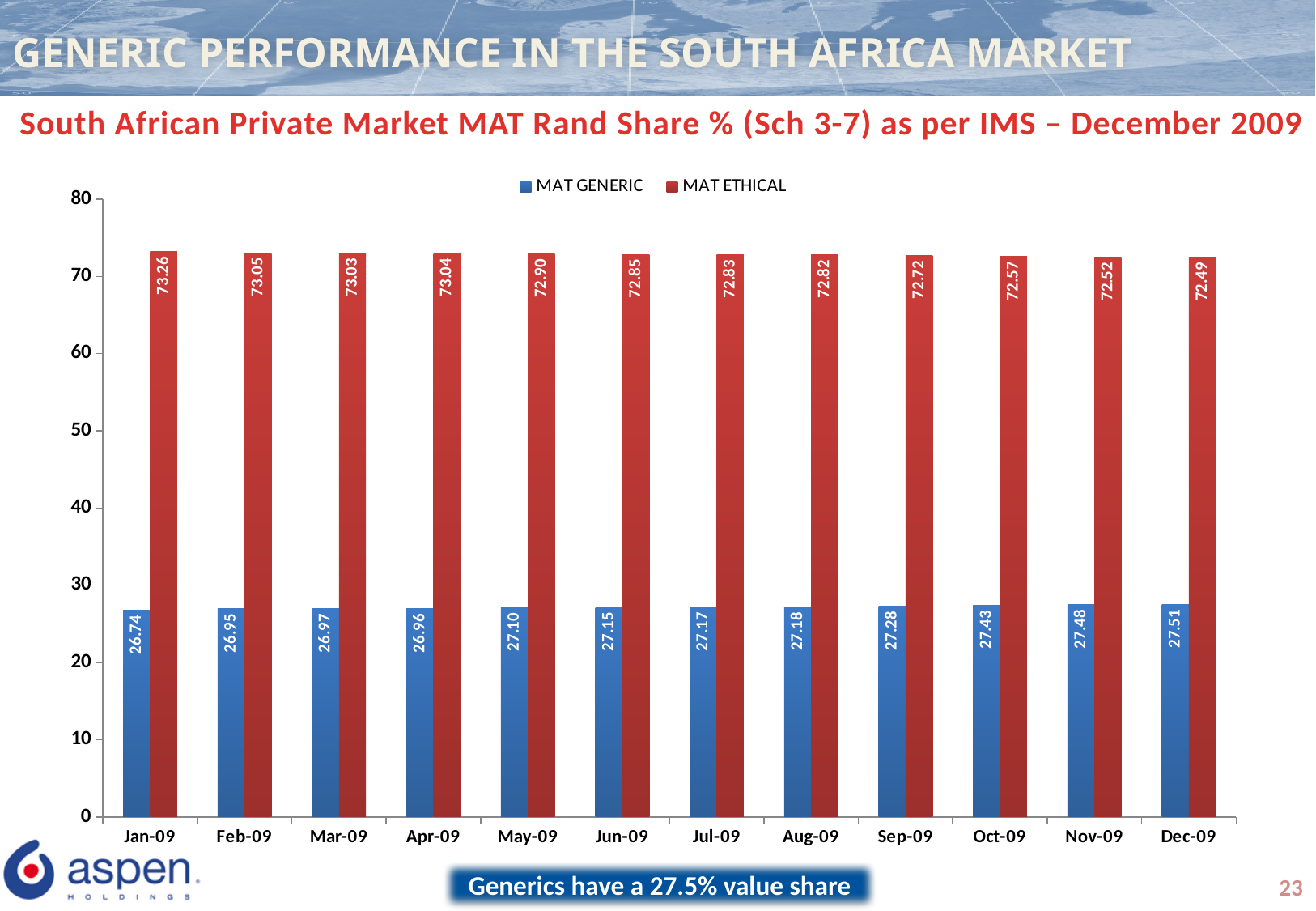
Which month has the lowest MAT GENERIC value? Jan-09 What colour are the MAT ETHICAL bars? Red Which is larger in Jun-09, MAT GENERIC or MAT ETHICAL? MAT ETHICAL How many series does the legend list? 2 Which month has the highest MAT ETHICAL value? Jan-09 What is the MAT ETHICAL value for Dec-09? 72.49 What is the MAT GENERIC value for Sep-09? 27.28 Do the MAT GENERIC values rise or fall from Jan-09 to Dec-09? Rise What is the difference between the MAT ETHICAL and MAT GENERIC values for Dec-09? 44.98 What is the MAT GENERIC value for Jan-09? 26.74 How many months are shown on the x axis? 12 What kind of chart is shown on the slide? Bar chart